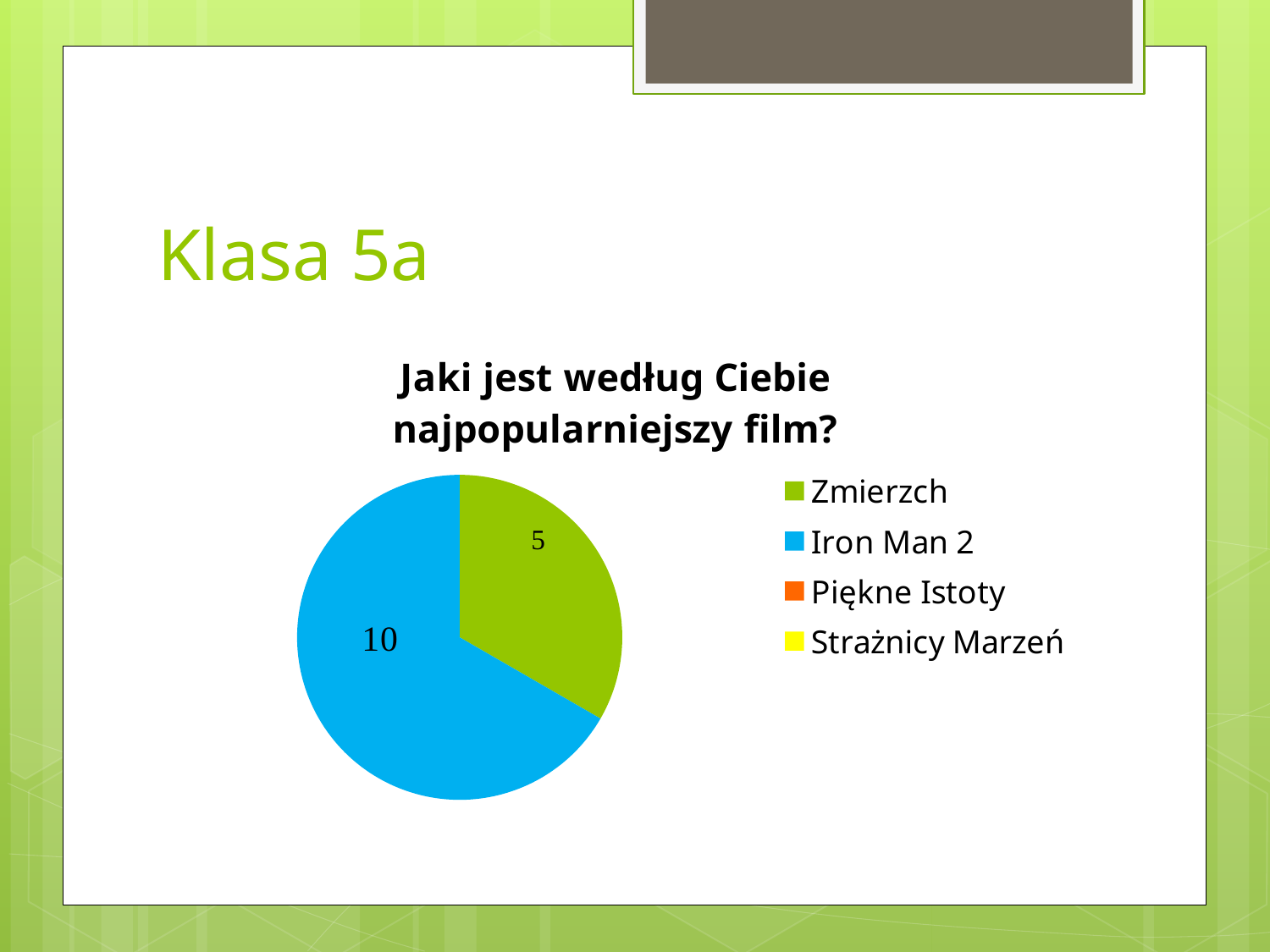
Which of the two labelled slices is smaller, Zmierzch or Iron Man 2? Zmierzch What is the total of the labelled slices in the pie? 15 What is the title of the chart? Jaki jest według Ciebie najpopularniejszy film? What is the value for Zmierzch? 5 Which colour represents Iron Man 2 in the chart? blue Which is larger, the value for Zmierzch or the value for Iron Man 2? Iron Man 2 How many entries does the legend list? 4 What is the value for Iron Man 2? 10 What kind of chart is shown on the slide? pie chart What is the difference between the values for Iron Man 2 and Zmierzch? 5 How many slices with data labels are visible in the pie? 2 Which film has the largest slice of the pie? Iron Man 2